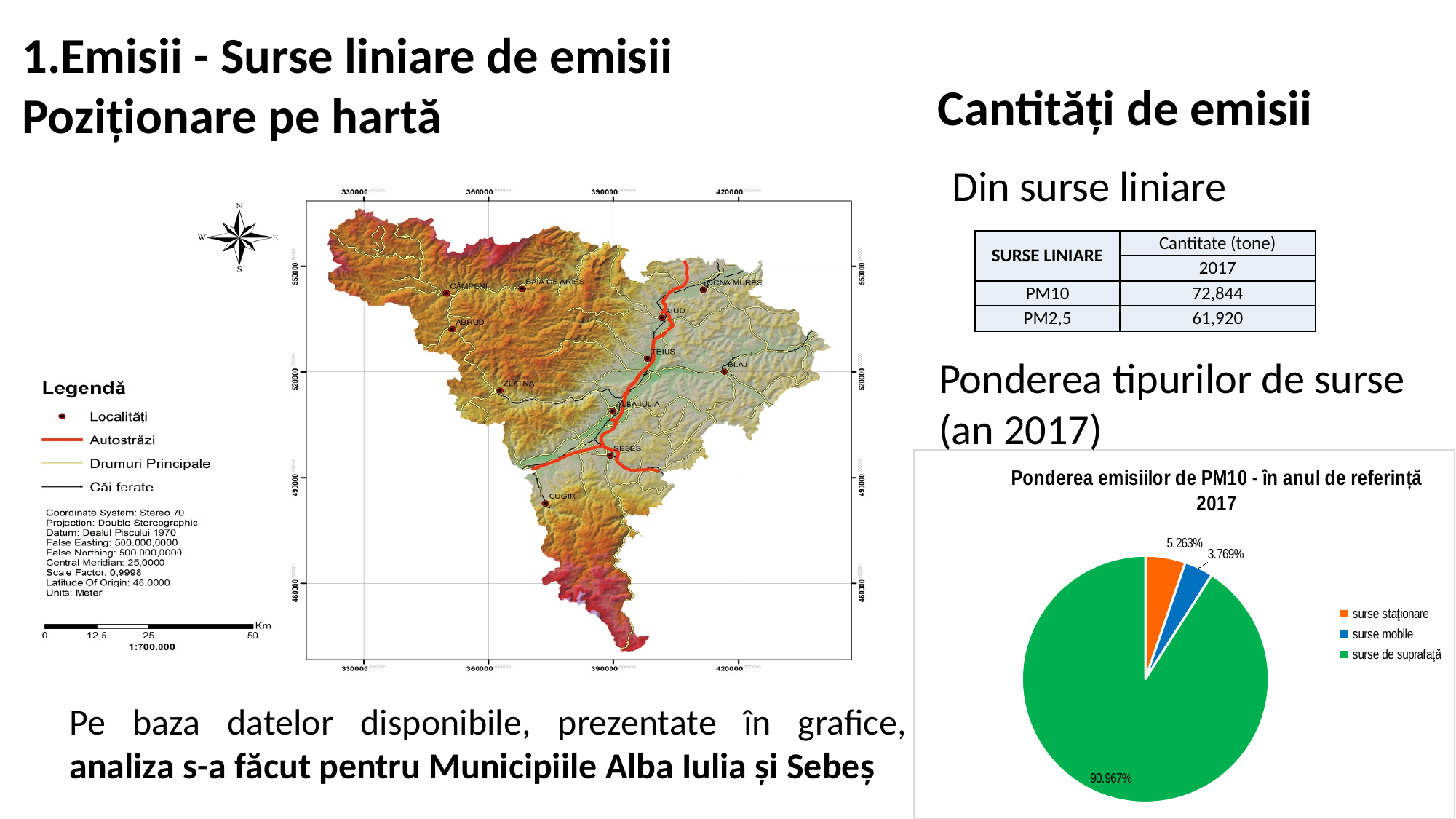
What kind of chart is shown on the slide? pie chart What share of the pie chart is 'surse staționare'? 5.263% What is the difference between the shares of 'surse staționare' and 'surse mobile' in the pie chart? 1.494% Which is larger in the pie chart, 'surse staționare' or 'surse mobile'? surse staționare Which category has the largest slice in the pie chart? surse de suprafață How many slices does the pie chart have? 3 What is the title of the pie chart? Ponderea emisiilor de PM10 - în anul de referință 2017 How many entries does the legend of the pie chart list? 3 Which category has the smallest slice in the pie chart? surse mobile What share of the pie chart is 'surse mobile'? 3.769% Which colour represents 'surse de suprafață' in the pie chart? green What share of the pie chart is 'surse de suprafață'? 90.967%